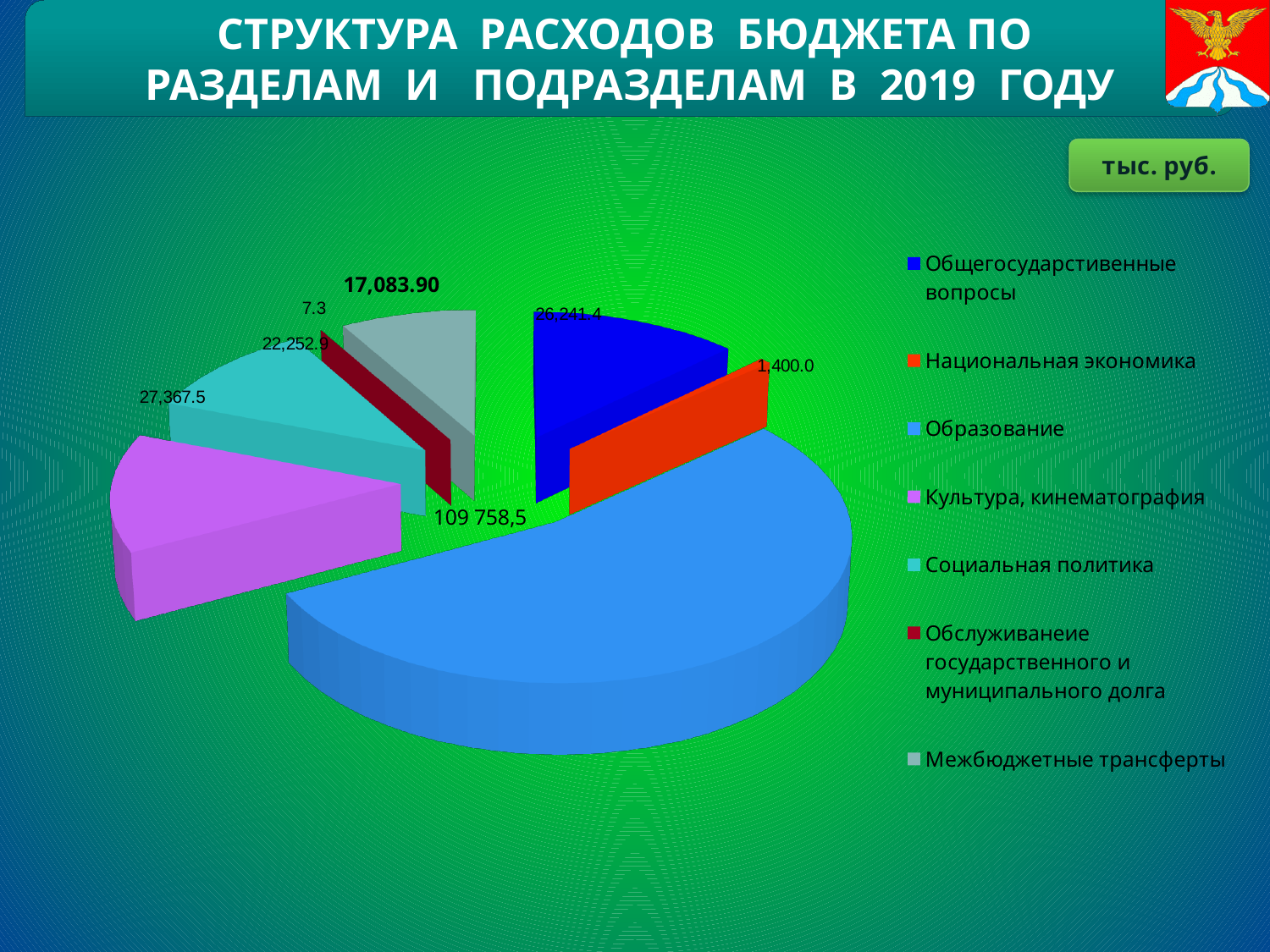
Which is larger, Культура, кинематография or Социальная политика? Культура, кинематография What is the value shown for Межбюджетные трансферты? 17,083.90 What is the difference between the values for Культура, кинематография and Социальная политика? 5,114.6 How many categories does the legend of the pie chart list? 7 What is the value shown for Общегосударственные вопросы? 26,241.4 What is the value shown for Национальная экономика? 1,400.0 What unit is indicated for the values on the slide? тыс. руб. Which category has the largest slice of the pie? Образование Which category has the smallest slice of the pie? Обслуживание государственного и муниципального долга What is the value shown for Обслуживание государственного и муниципального долга? 7.3 What is the value shown for Образование? 109 758,5 What kind of chart is shown on the slide? pie chart